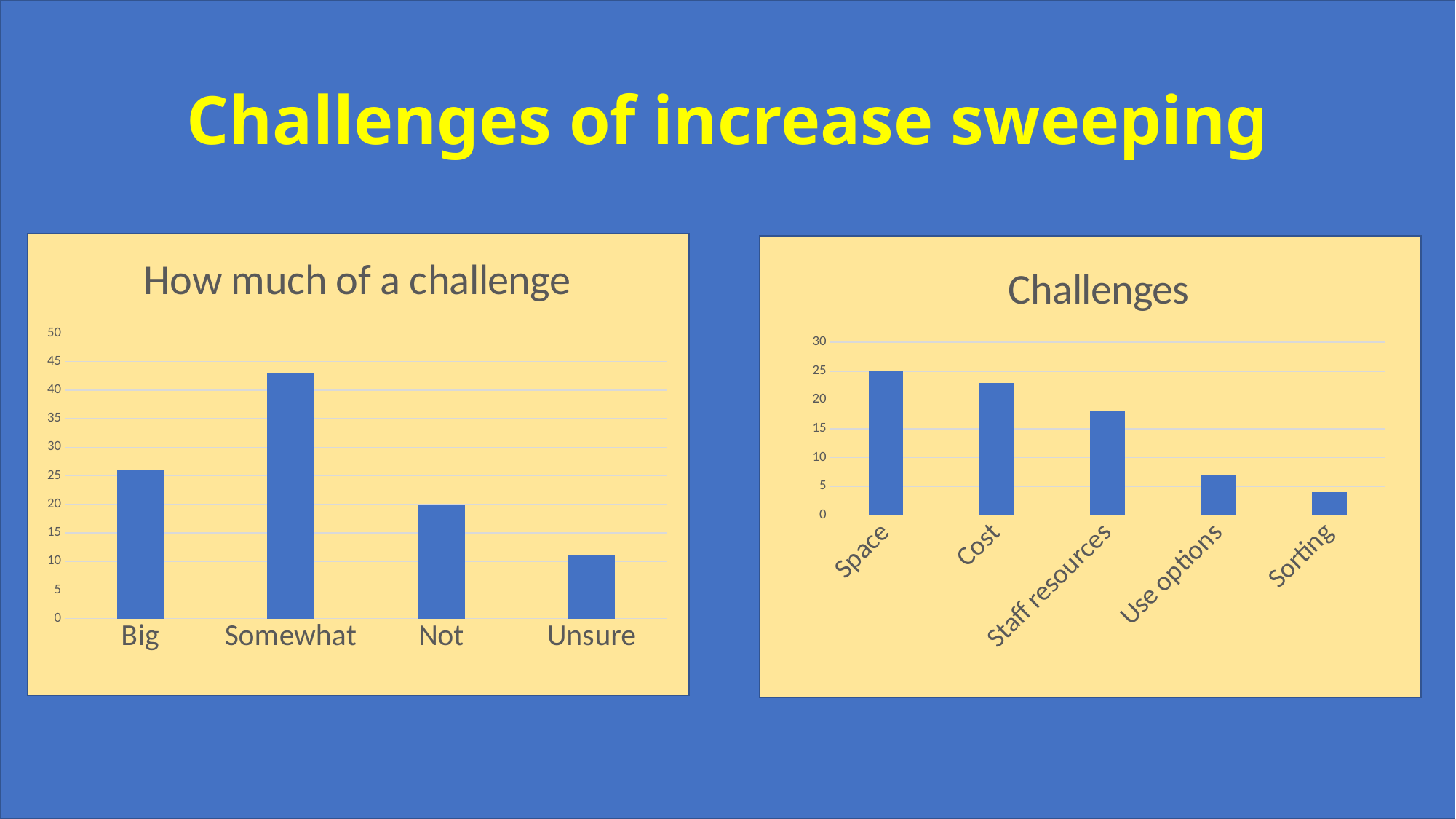
On the 'How much of a challenge' chart, is the value for Big greater or less than 30? less On the 'How much of a challenge' chart, how many categories are shown? 4 What kind of chart is the 'Challenges' chart? bar chart On the 'Challenges' chart, do the values rise or fall from left to right along the x axis? fall On the 'How much of a challenge' chart, is the value for Somewhat greater or less than 40? greater On the 'How much of a challenge' chart, what is the value for Not? 20 On the 'Challenges' chart, which category has the highest value? Space On the 'Challenges' chart, what is the value for Space? 25 On the 'Challenges' chart, which category has the lowest value? Sorting On the 'How much of a challenge' chart, which category has the lowest value? Unsure On the 'Challenges' chart, is the value for Use options greater or less than 10? less On the 'How much of a challenge' chart, which category has the highest value? Somewhat